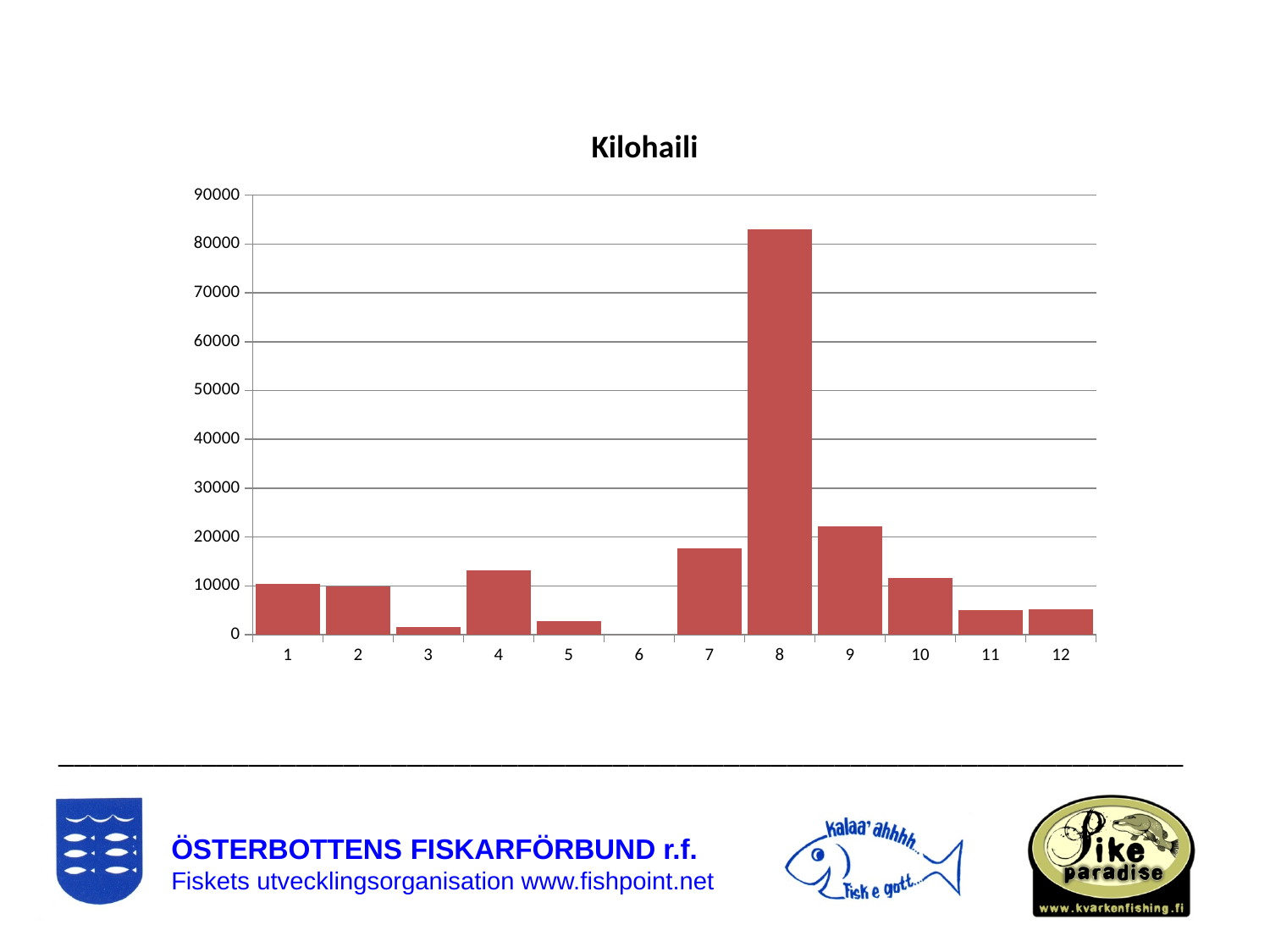
Is the value for category 8 greater or less than 80000? greater What kind of chart is shown on the slide? bar chart Is the value for category 9 greater or less than 20000? greater Which category has the lowest value in the chart? 6 Which is larger, the value for category 4 or the value for category 5? 4 Is the value for category 7 greater or less than 20000? less Which category has the highest value in the chart? 8 How many categories are shown on the x axis of the chart? 12 What is the title of the chart? Kilohaili Which is larger, the value for category 8 or the value for category 9? 8 What colour are the bars in the chart? red